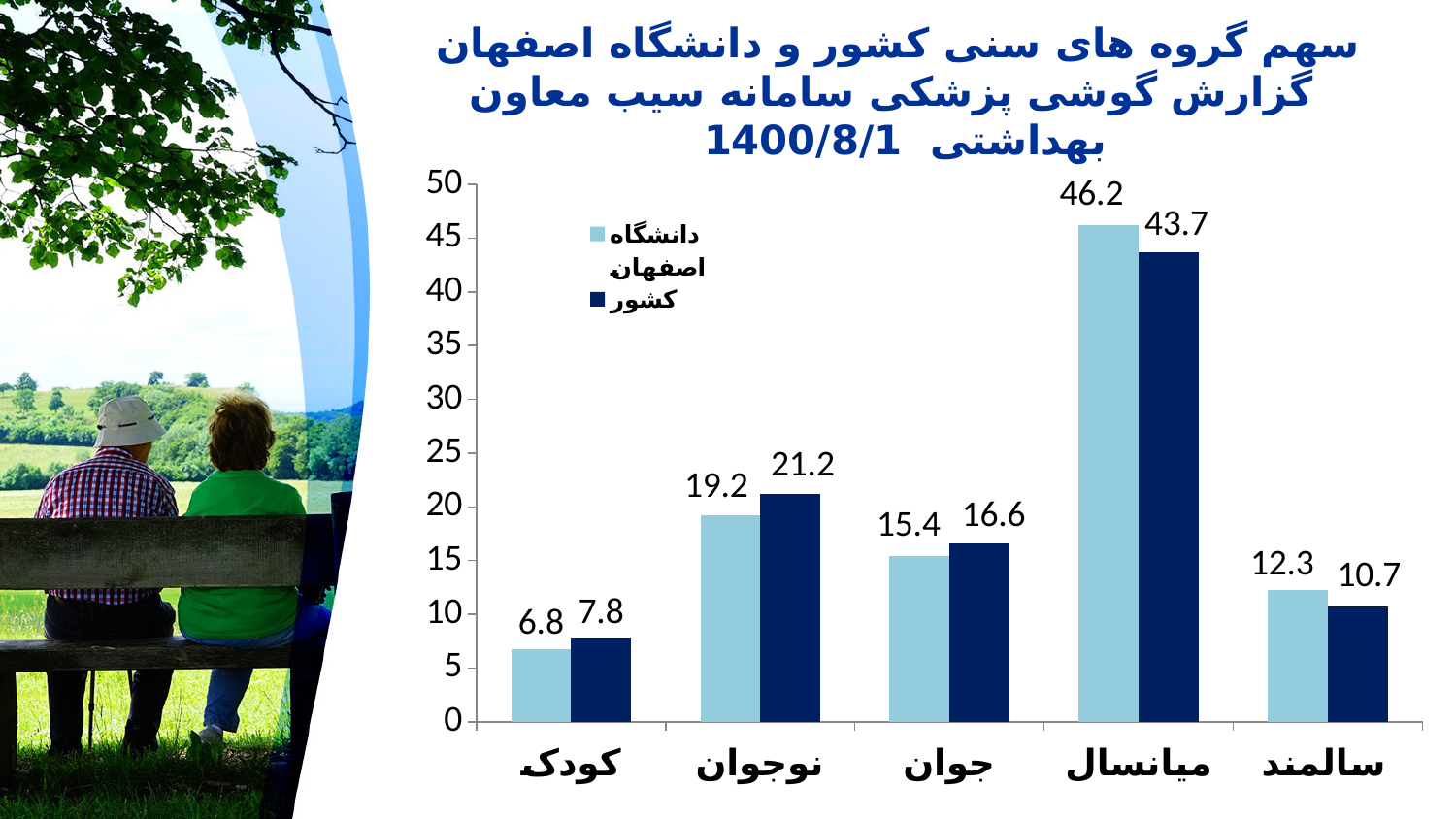
Which category has the highest value for the کشور series? میانسال Which series is shown in dark blue in the legend? کشور Which category has the lowest value for the دانشگاه اصفهان series? کودک What kind of chart is shown on the slide? bar chart In the جوان category, which series has the larger value, دانشگاه اصفهان or کشور? کشور What is the difference between the دانشگاه اصفهان and کشور values in the میانسال category? 2.5 How many age-group categories are shown on the x axis? 5 What is the value for دانشگاه اصفهان in the کودک category? 6.8 What is the value for کشور in the نوجوان category? 21.2 What is the value for دانشگاه اصفهان in the سالمند category? 12.3 How many series does the legend list? 2 Is the value for کشور in the سالمند category greater or less than 15? less